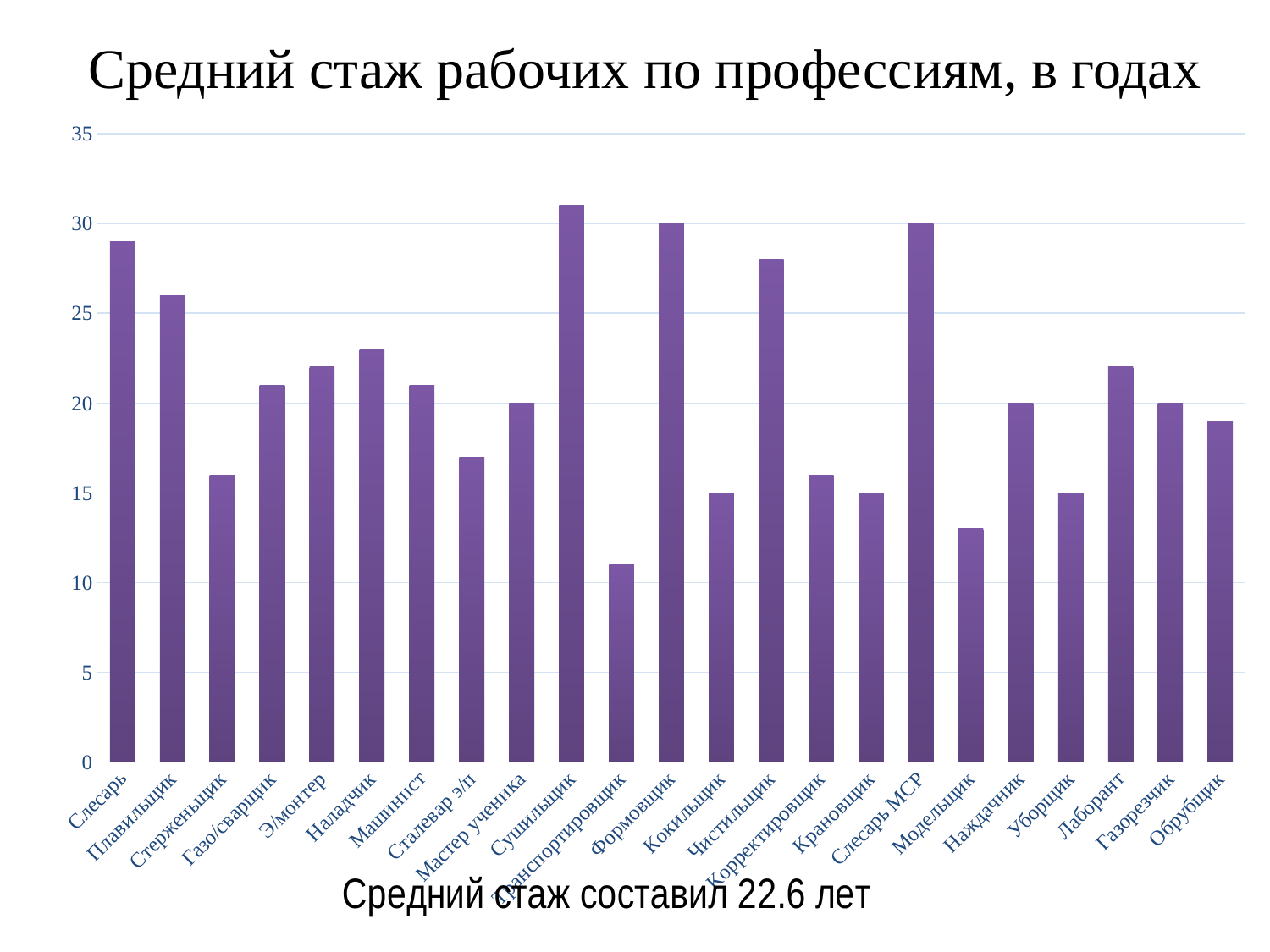
What is the value for Мастер ученика? 20 Which profession has the highest average work experience? Сушильщик How many professions (categories) are shown on the x axis? 23 What kind of chart is shown on the slide? bar chart Which is larger, the value for Транспортировщик or the value for Модельщик? Модельщик What is the title of the chart? Средний стаж рабочих по профессиям, в годах Is the value for Слесарь greater or less than 25? greater What is the value for Формовщик? 30 Is the value for Модельщик greater or less than 15? less Which is larger, the value for Слесарь or the value for Плавильщик? Слесарь Which profession has the lowest average work experience? Транспортировщик What is the value for Кокильщик? 15